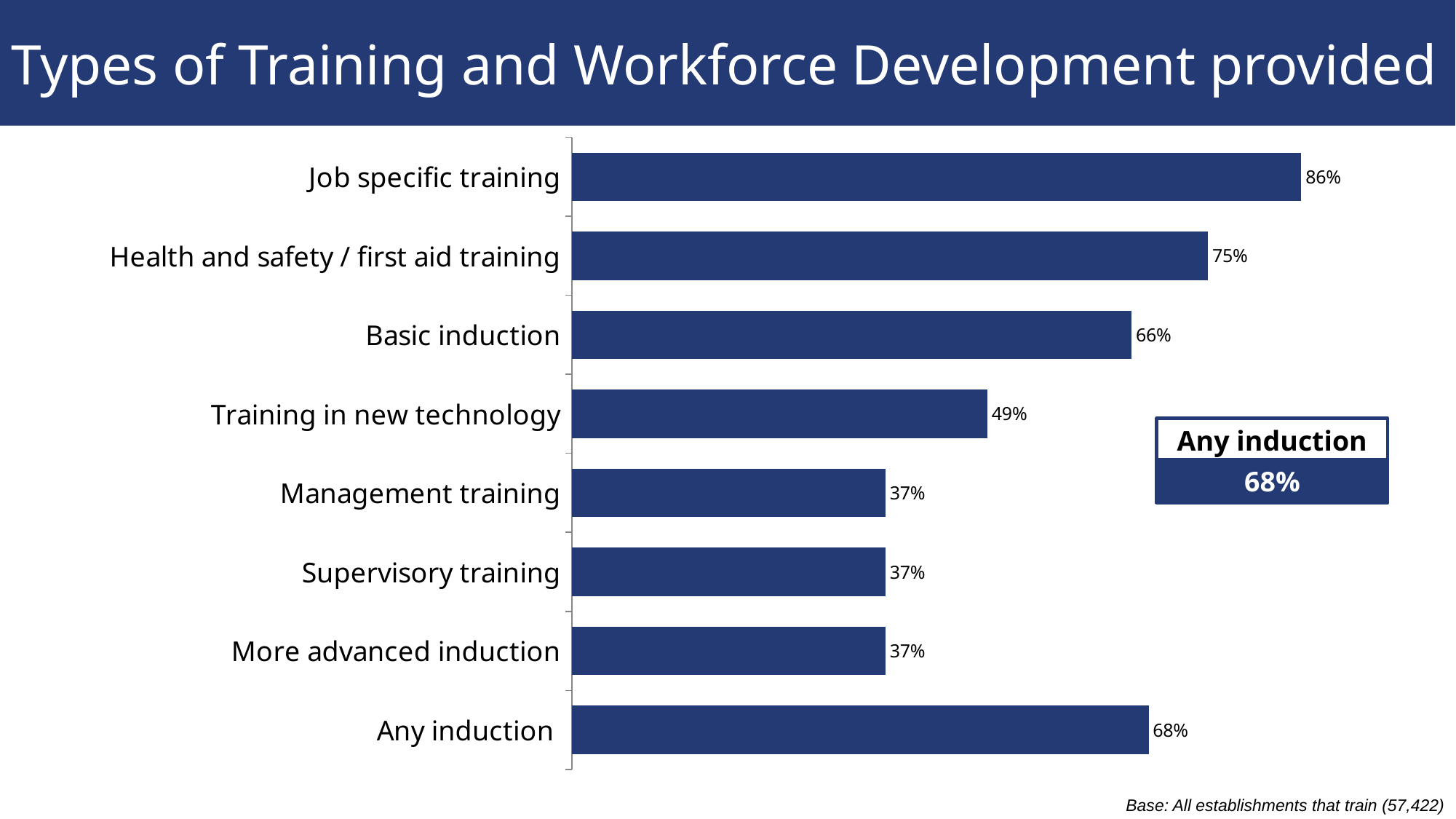
What is the value for Training in new technology? 49% What is the title of the slide? Types of Training and Workforce Development provided What is the value for Health and safety / first aid training? 75% Which type of training has the highest value? Job specific training What is the value for Any induction? 68% What is the difference between Health and safety / first aid training and Training in new technology? 26% What percentage of establishments provide job specific training? 86% Which is larger, Basic induction or Training in new technology? Basic induction What kind of chart is shown on the slide? Bar chart What is the difference between Job specific training and Basic induction? 20% How many categories are shown in the chart? 8 How many categories share the value 37%? 3